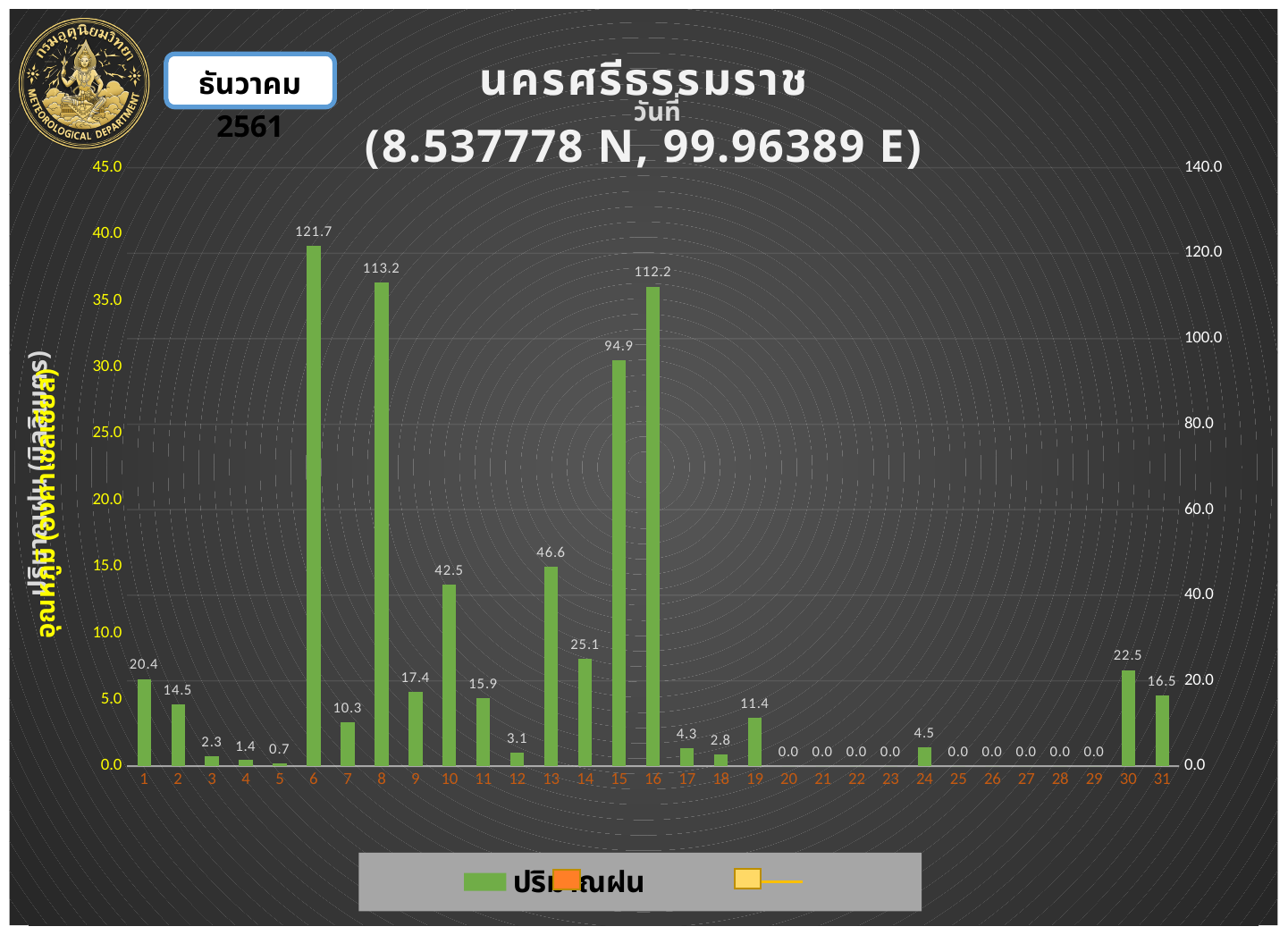
What is the value for day 13? 46.6 How many days (categories) are shown on the x axis? 31 What kind of chart is shown on the slide? bar chart What is the value for day 6? 121.7 What is the difference between the values for day 1 and day 2? 5.9 What is the title of the chart? นครศรีธรรมราช (8.537778 N, 99.96389 E) What is the value for day 30? 22.5 What is the lowest value shown on the chart? 0.0 Which is larger, the value for day 10 or the value for day 13? day 13 Which day has the highest value? 6 What is the value for day 16? 112.2 What is the difference between the values for day 8 and day 16? 1.0